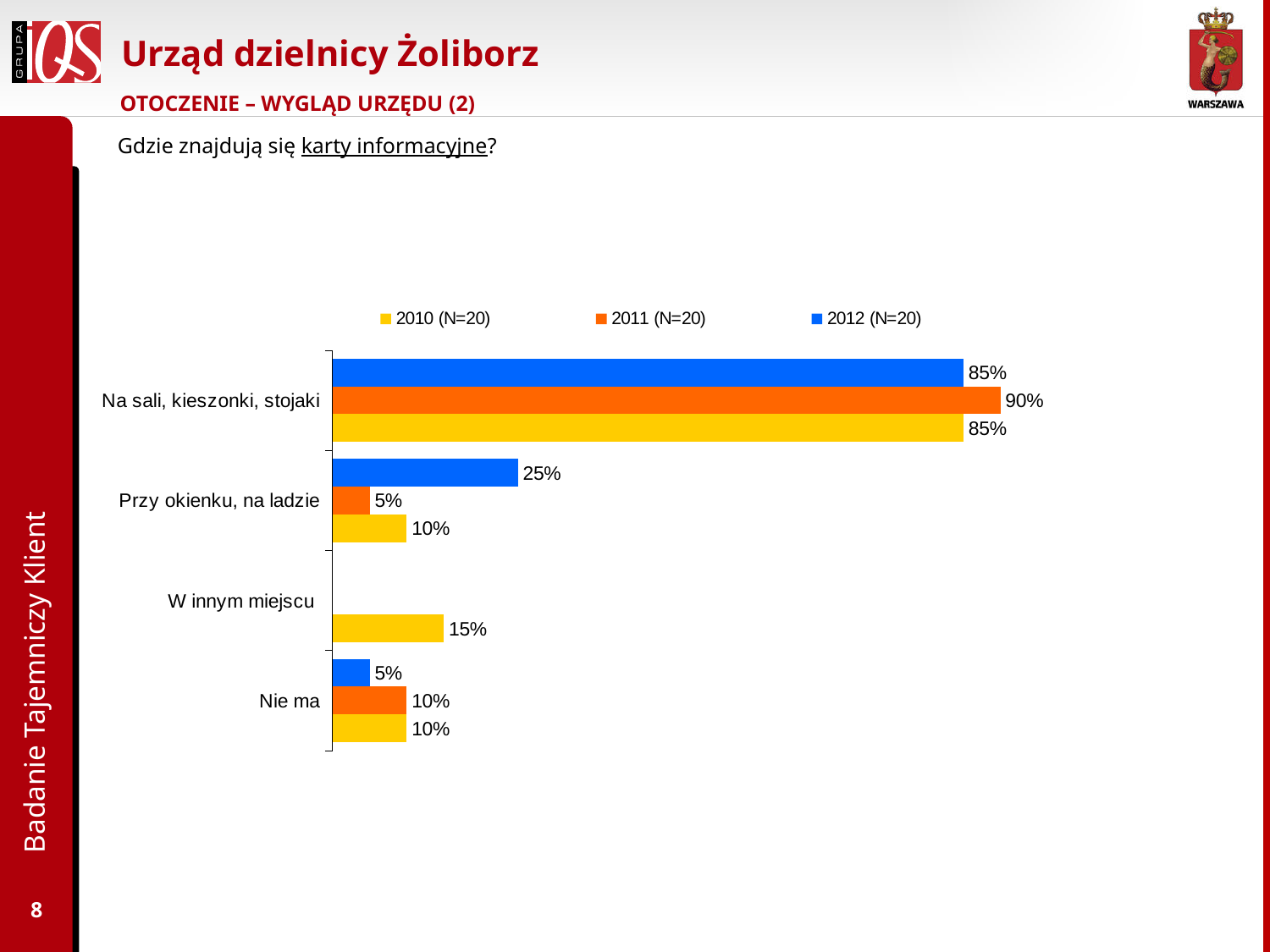
What is the value for 'Na sali, kieszonki, stojaki' in the 2011 (N=20) series? 90% What is the value for 'W innym miejscu' in the 2010 (N=20) series? 15% Which category has the lowest value in the 2011 (N=20) series among those with a bar? Przy okienku, na ladzie What kind of chart is shown on the slide? bar chart Which category has the highest value in the 2012 (N=20) series? Na sali, kieszonki, stojaki Which is larger for 'Nie ma': the 2010 (N=20) value or the 2012 (N=20) value? 2010 (N=20) How many categories are shown on the chart? 4 How many series does the legend list? 3 Which colour represents the 2011 (N=20) series in the legend? orange What is the value for 'Przy okienku, na ladzie' in the 2012 (N=20) series? 25% What is the value for 'Nie ma' in the 2012 (N=20) series? 5% What is the difference between the 2012 (N=20) and 2011 (N=20) values for 'Przy okienku, na ladzie'? 20%